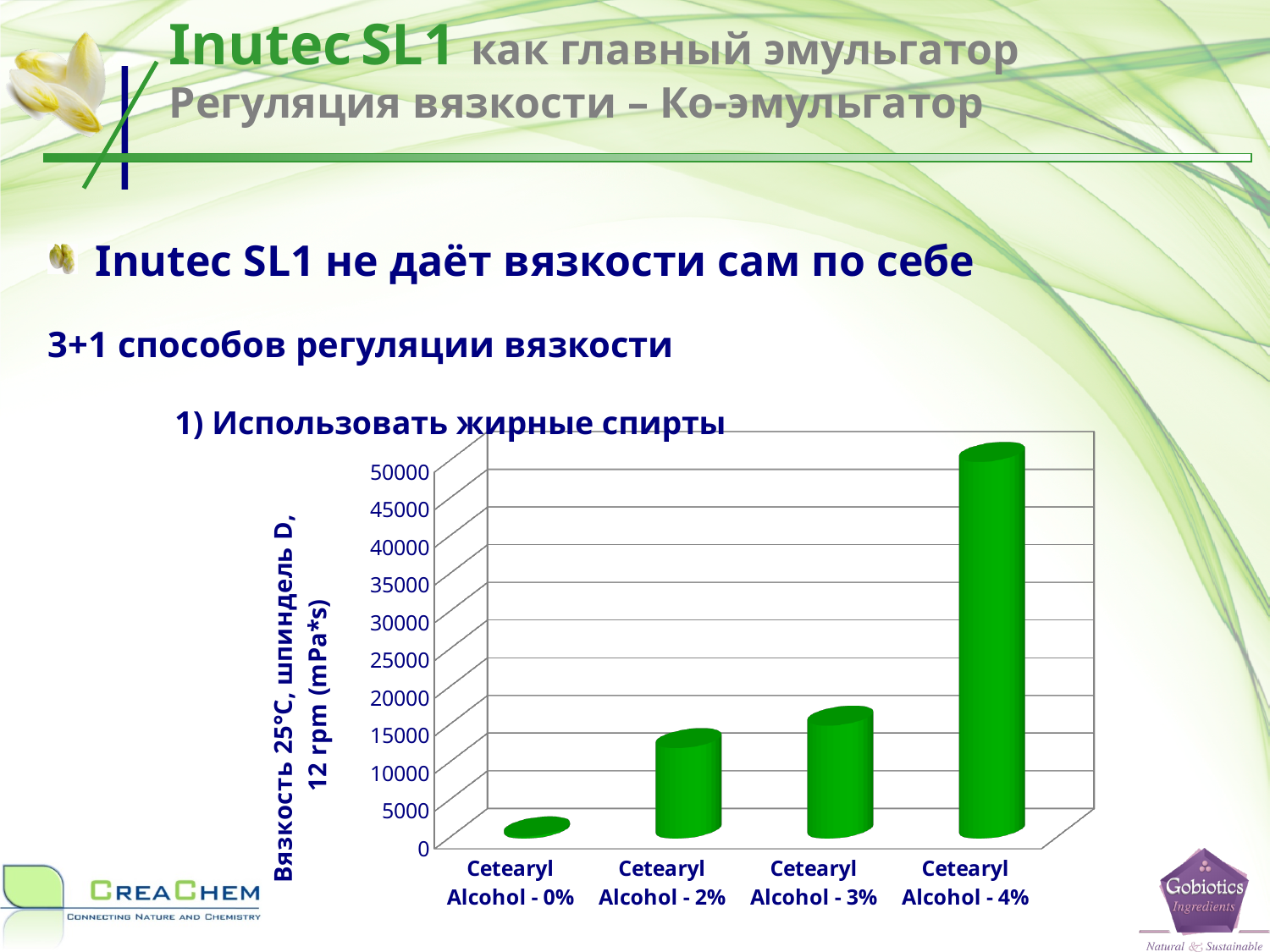
Which is larger, the value for Cetearyl Alcohol - 3% or Cetearyl Alcohol - 2%? Cetearyl Alcohol - 3% Do the values rise or fall as the Cetearyl Alcohol percentage increases along the x axis? Rise Is the value for Cetearyl Alcohol - 2% greater or less than 10000? greater What kind of chart is shown on the slide? Bar chart Is the value for Cetearyl Alcohol - 0% greater or less than 5000? less Which category has the highest viscosity value? Cetearyl Alcohol - 4% Is the value for Cetearyl Alcohol - 4% greater or less than 45000? greater How many categories are plotted on the chart? 4 Which is larger, the value for Cetearyl Alcohol - 4% or Cetearyl Alcohol - 3%? Cetearyl Alcohol - 4% Which category has the lowest viscosity value? Cetearyl Alcohol - 0% What is the label on the vertical axis of the chart? Вязкость 25°C, шпиндель D, 12 rpm (mPa*s)